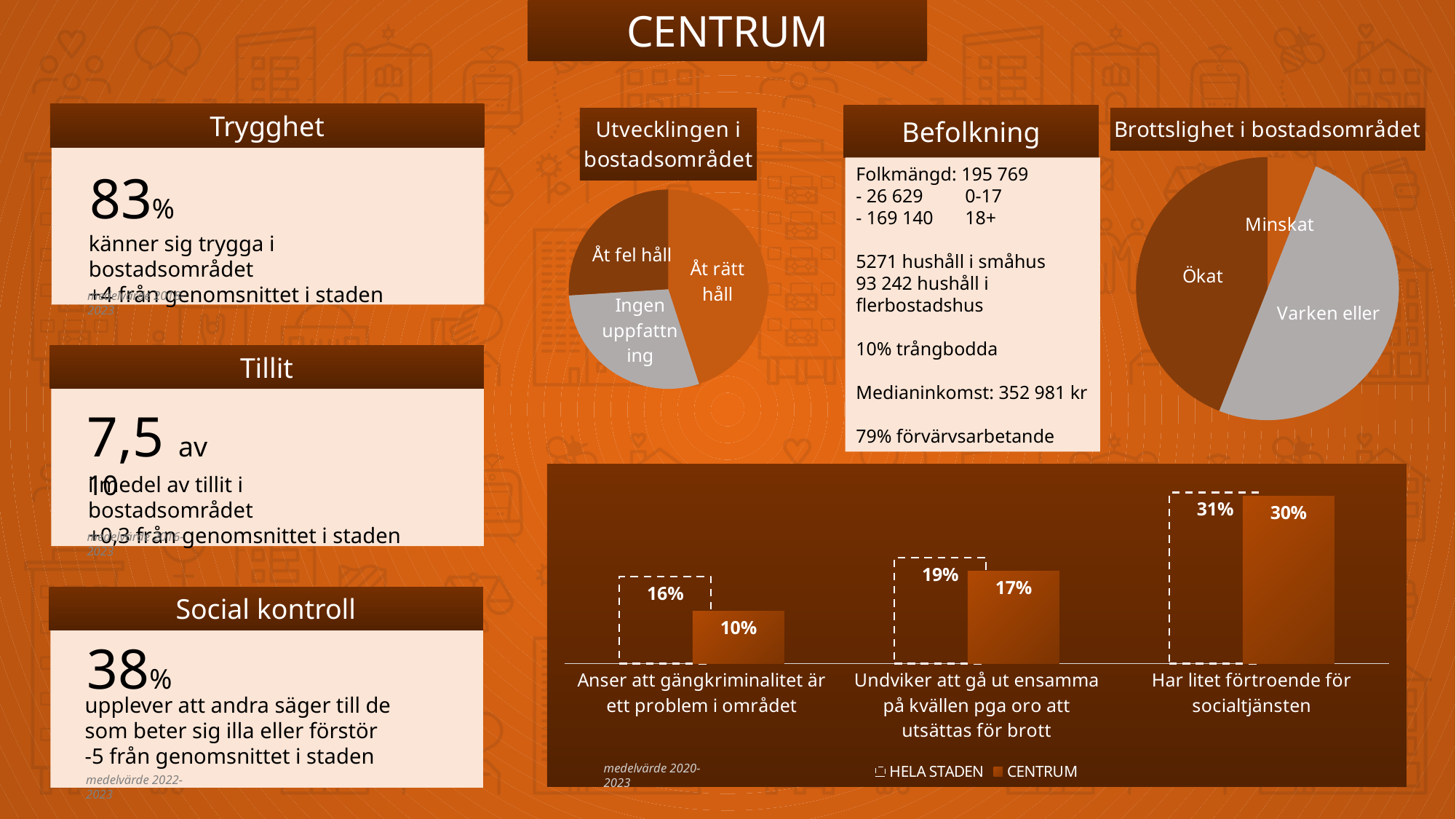
In the bar chart at the bottom of the slide, which category has the highest CENTRUM value? Har litet förtroende för socialtjänsten In the bar chart at the bottom of the slide, which category has the lowest HELA STADEN value? Anser att gängkriminalitet är ett problem i området In the bar chart at the bottom of the slide, what is the CENTRUM value for "Har litet förtroende för socialtjänsten"? 30% In the bar chart at the bottom of the slide, what is the difference between the HELA STADEN and CENTRUM values for "Anser att gängkriminalitet är ett problem i området"? 6% In the bar chart at the bottom of the slide, which is larger for "Undviker att gå ut ensamma på kvällen pga oro att utsättas för brott": HELA STADEN or CENTRUM? HELA STADEN How many categories are shown in the bar chart at the bottom of the slide? 3 In the bar chart at the bottom of the slide, what is the CENTRUM value for "Anser att gängkriminalitet är ett problem i området"? 10% In the pie chart titled "Brottslighet i bostadsområdet", which slice is larger: "Ökat" or "Minskat"? Ökat What kind of chart is the chart titled "Brottslighet i bostadsområdet"? Pie chart In the bar chart at the bottom of the slide, what is the HELA STADEN value for "Undviker att gå ut ensamma på kvällen pga oro att utsättas för brott"? 19% How many slices does the pie chart titled "Utvecklingen i bostadsområdet" have? 3 How many series does the legend of the bar chart at the bottom of the slide list? 2